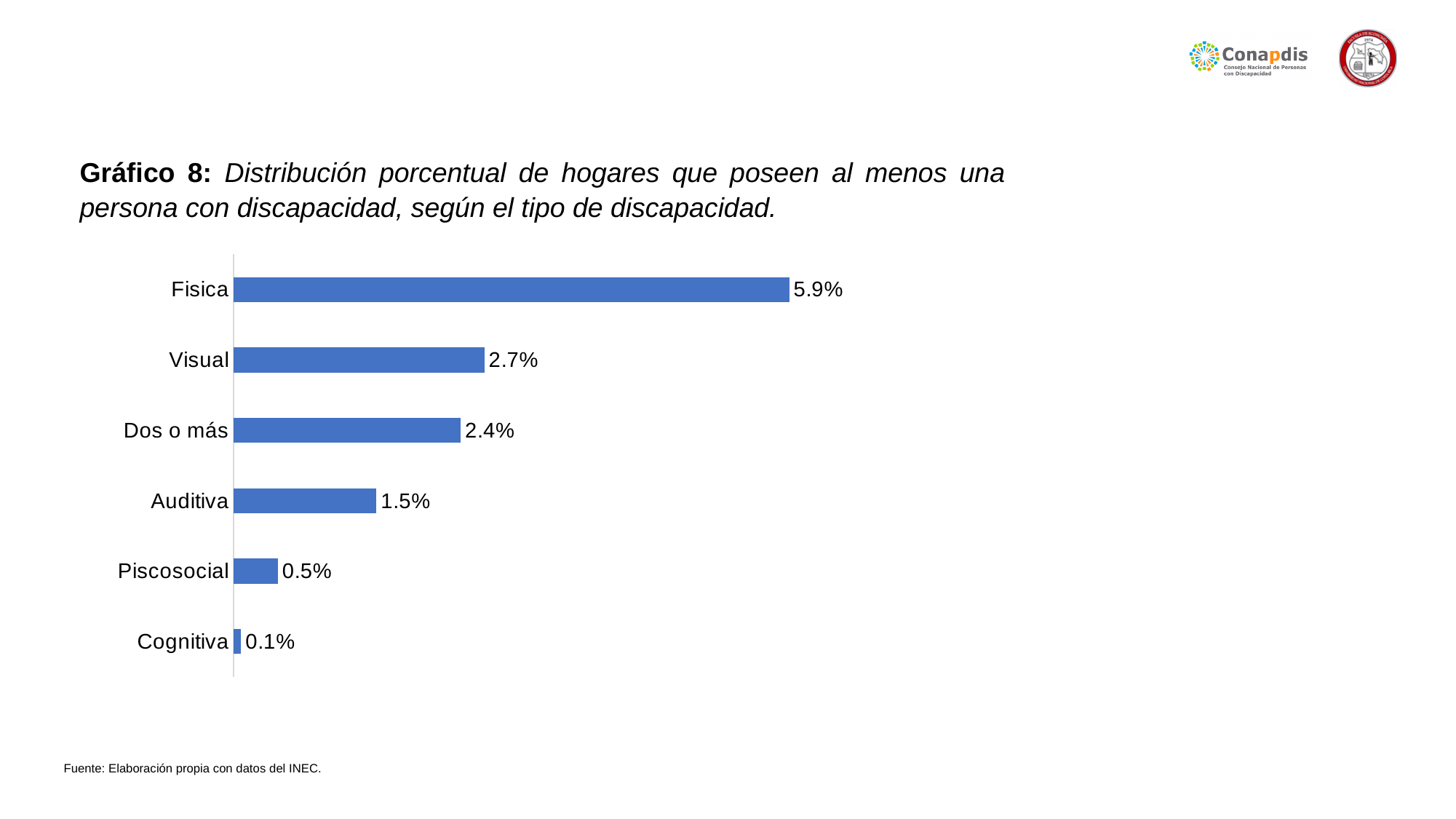
Which category has the highest value? Fisica Which is larger, the value for Visual or the value for Dos o más? Visual What is the difference between the values for Dos o más and Auditiva? 0.9% What is the value for Auditiva? 1.5% What is the source cited below the chart? Elaboración propia con datos del INEC. What is the value for Visual? 2.7% How many categories are shown in the chart? 6 Which category has the lowest value? Cognitiva What is the value for Fisica? 5.9% What kind of chart is shown on the slide? Bar chart What is the difference between the values for Fisica and Visual? 3.2% What is the value for Piscosocial? 0.5%